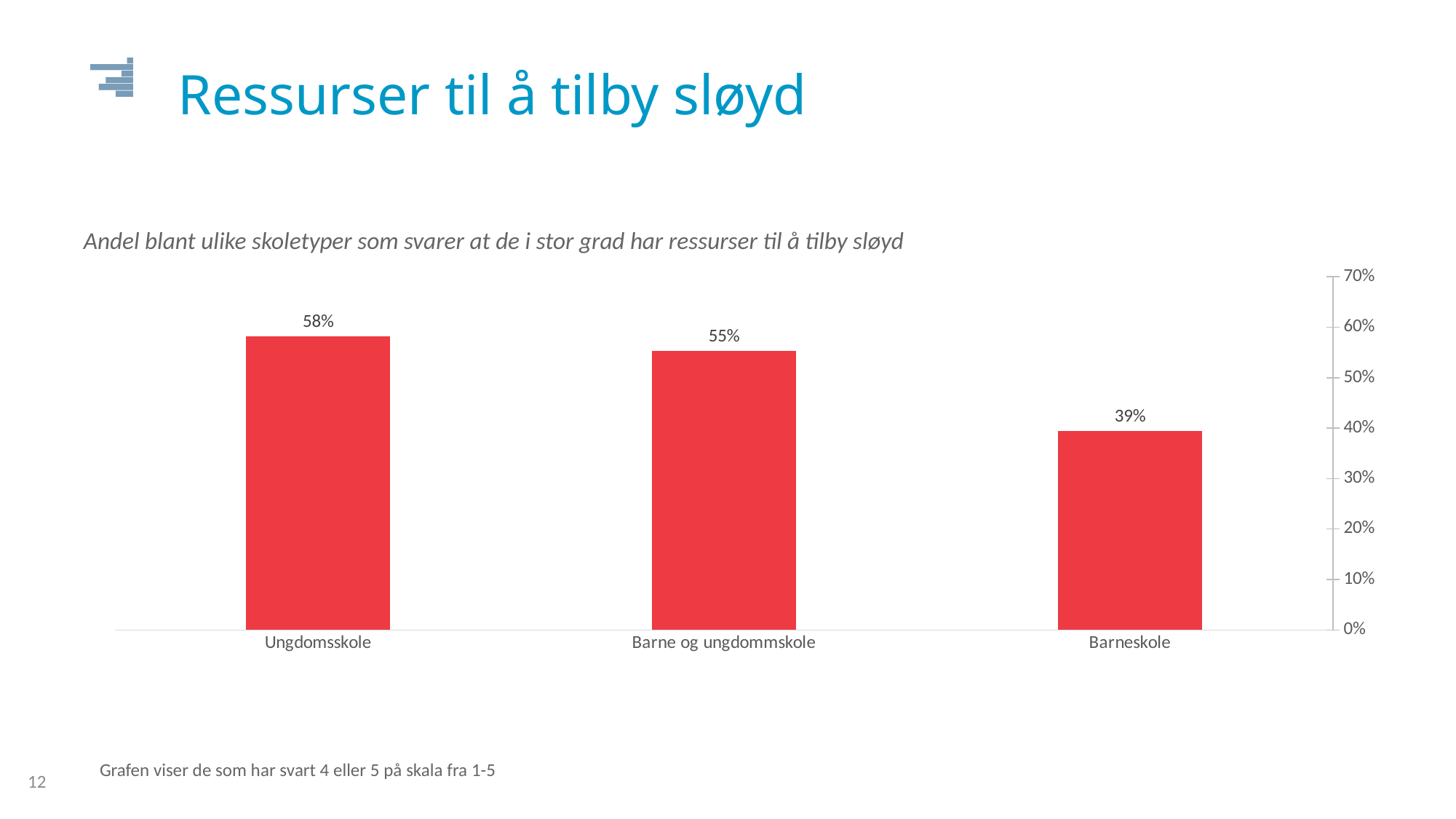
Which school type has the highest value? Ungdomsskole Which is larger, the value for Barne og ungdommskole or the value for Barneskole? Barne og ungdommskole What kind of chart is shown on the slide? bar chart Is the value for Barneskole greater or less than 40%? less What is the value for Barneskole? 39% What is the difference between the values for Barne og ungdommskole and Barneskole? 16 percentage points What is the difference between the values for Ungdomsskole and Barneskole? 19 percentage points What is the value for Ungdomsskole? 58% What is the highest value shown on the vertical axis? 70% What is the value for Barne og ungdommskole? 55% How many school types are shown in the chart? 3 Which school type has the lowest value? Barneskole